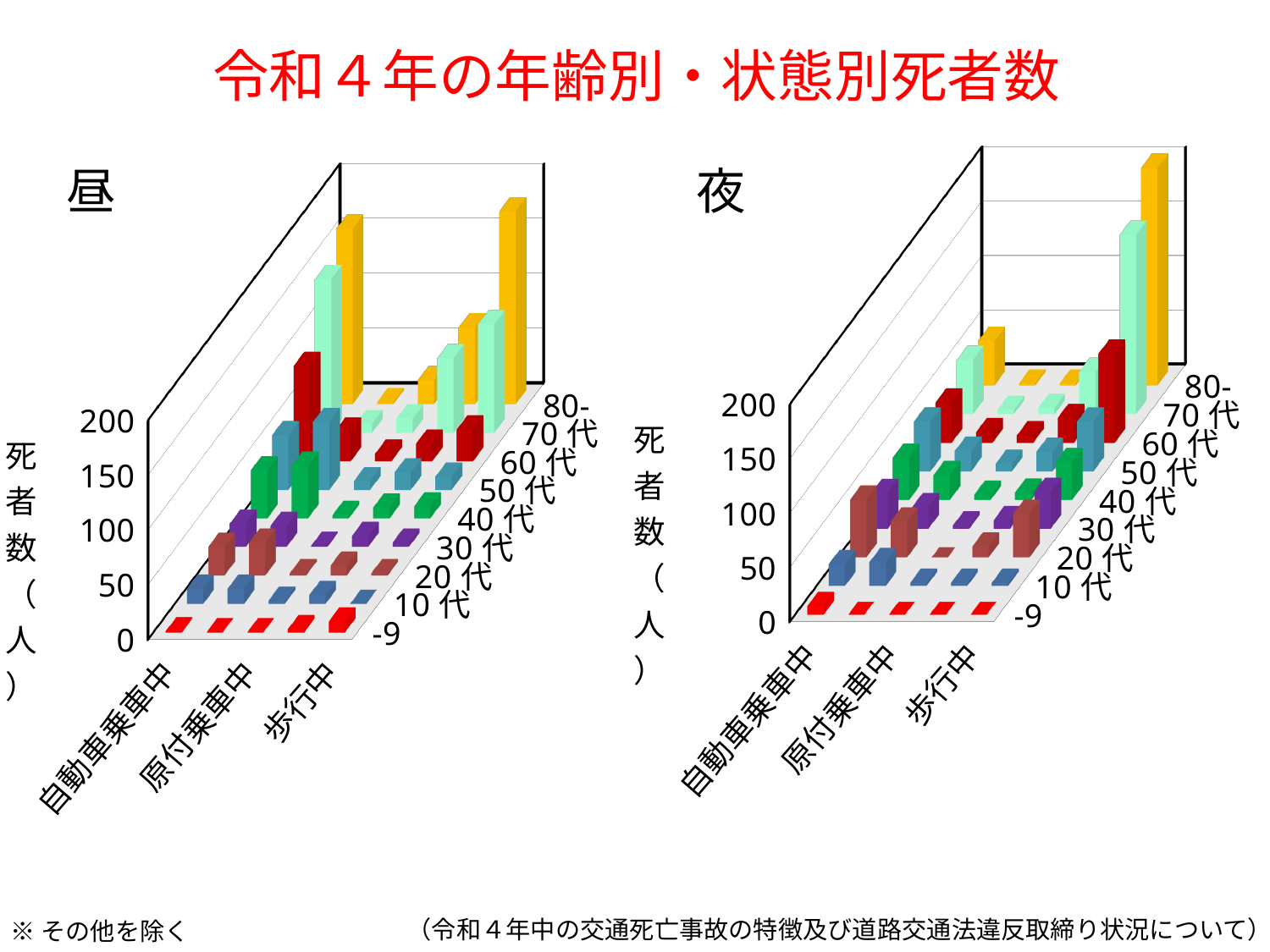
In the 昼 chart, is the value for 歩行中 in the 80- age group greater or less than 100? greater What is the title of the slide containing the two charts? 令和４年の年齢別・状態別死者数 How many age groups are shown along the depth axis of the 昼 chart? 9 In the 夜 chart, which age group has the tallest bar for 歩行中? 80- In the 昼 chart, which age group has the lowest bar for 自動車乗車中? -9 In the 夜 chart, which is larger for 歩行中: the 80- age group or the -9 age group? 80- What is the label of the vertical axis on the 夜 chart? 死者数（人） What kind of chart is used for the 昼 chart on the left? bar chart In the 夜 chart, is the value for 自動車乗車中 in the -9 age group greater or less than 50? less In the 昼 chart, is the value for 原付乗車中 in the 20代 age group greater or less than 50? less In the 昼 chart, which age group has the tallest bar for 歩行中? 80-